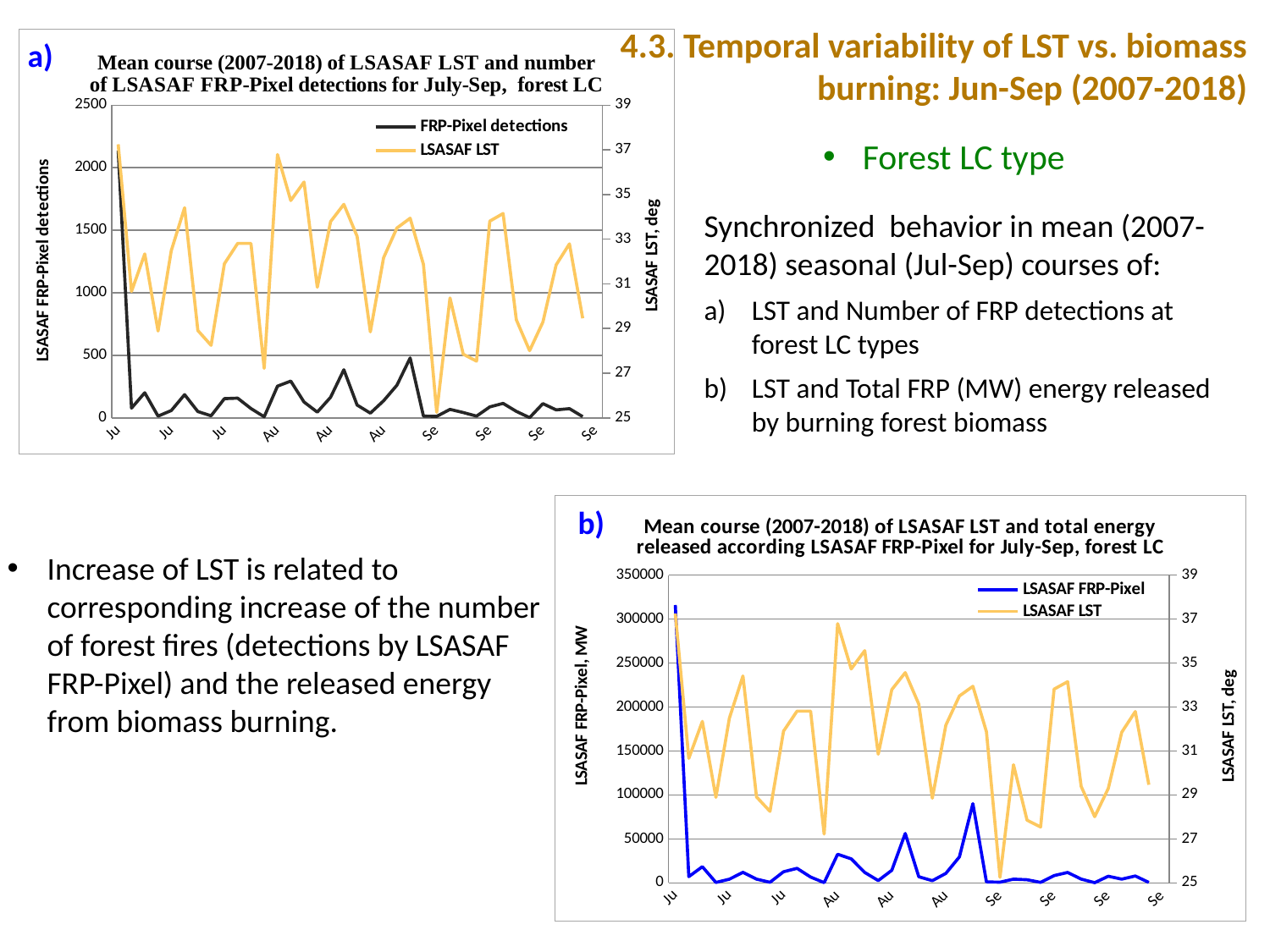
In chart b) (bottom right), is the first value of LSASAF FRP-Pixel greater or less than 250000? greater In chart b) (bottom right), does the LSASAF FRP-Pixel series overall rise or fall from the first point to the last point? fall What kind of chart is chart a) (top left)? line chart How many series does the legend of chart a) (top left) list? 2 In chart a) (top left), is the first value of FRP-Pixel detections greater or less than 1500? greater In chart a) (top left), which series is drawn in black? FRP-Pixel detections In chart b) (bottom right), what is the label of the left vertical axis? LSASAF FRP-Pixel, MW In chart b) (bottom right), is the highest value of LSASAF LST greater or less than 35? greater How many series does the legend of chart b) (bottom right) list? 2 In chart a) (top left), at which x-axis label does the FRP-Pixel detections series reach its highest value? the first Ju